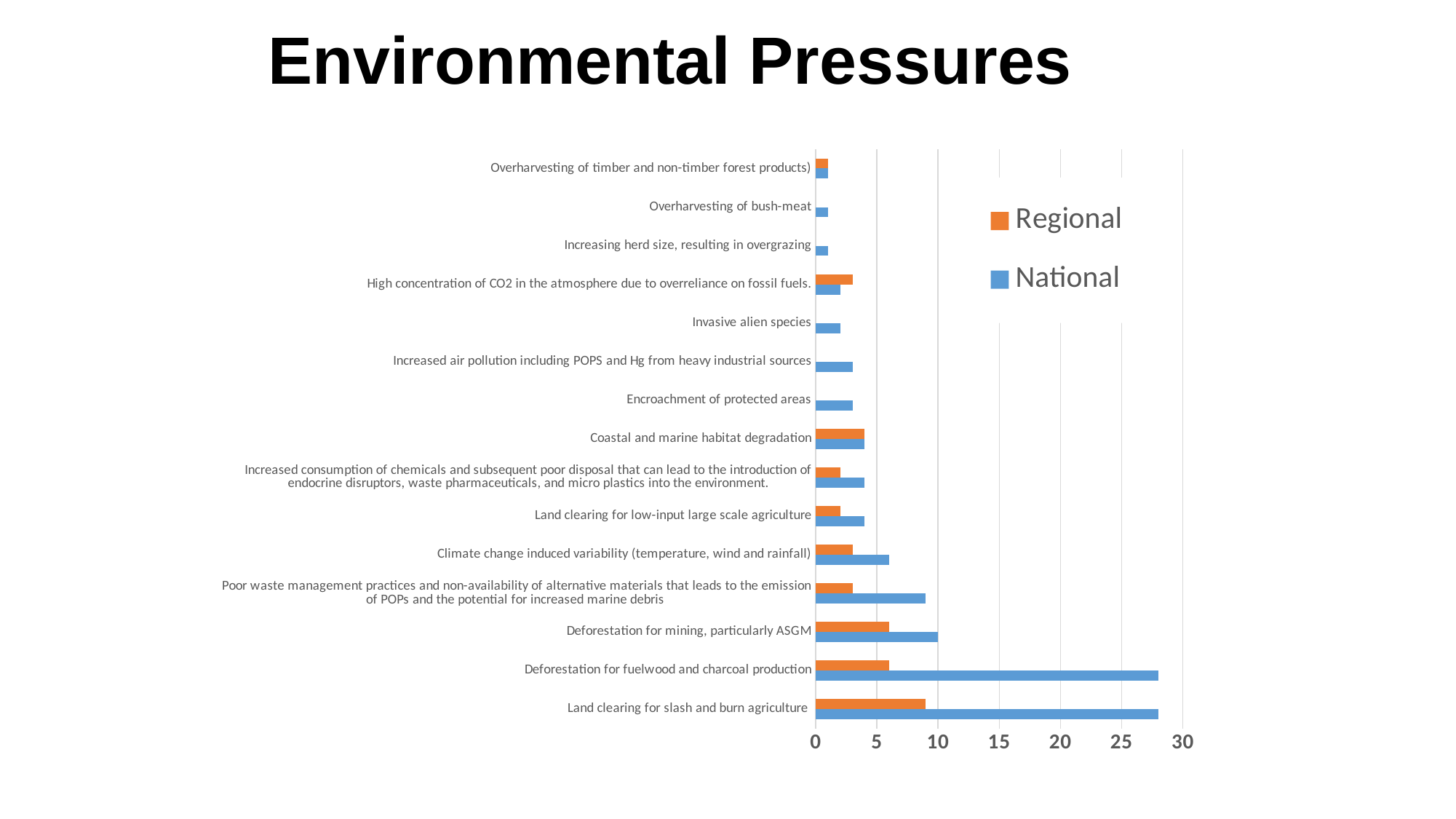
Is the National value for Climate change induced variability (temperature, wind and rainfall) greater or less than 5? greater What kind of chart is shown on the slide? bar chart Is the Regional value for Land clearing for slash and burn agriculture greater or less than 10? less What is the National value for Deforestation for mining, particularly ASGM? 10 How many series does the legend list? 2 How many categories are plotted on the chart? 15 Which category has the highest Regional value? Land clearing for slash and burn agriculture For Deforestation for fuelwood and charcoal production, which is larger: the Regional value or the National value? National Is the National value for Land clearing for slash and burn agriculture greater or less than 25? greater What colour represents the Regional series in the legend? orange Which is larger: the National value for Climate change induced variability or the National value for Land clearing for low-input large scale agriculture? Climate change induced variability